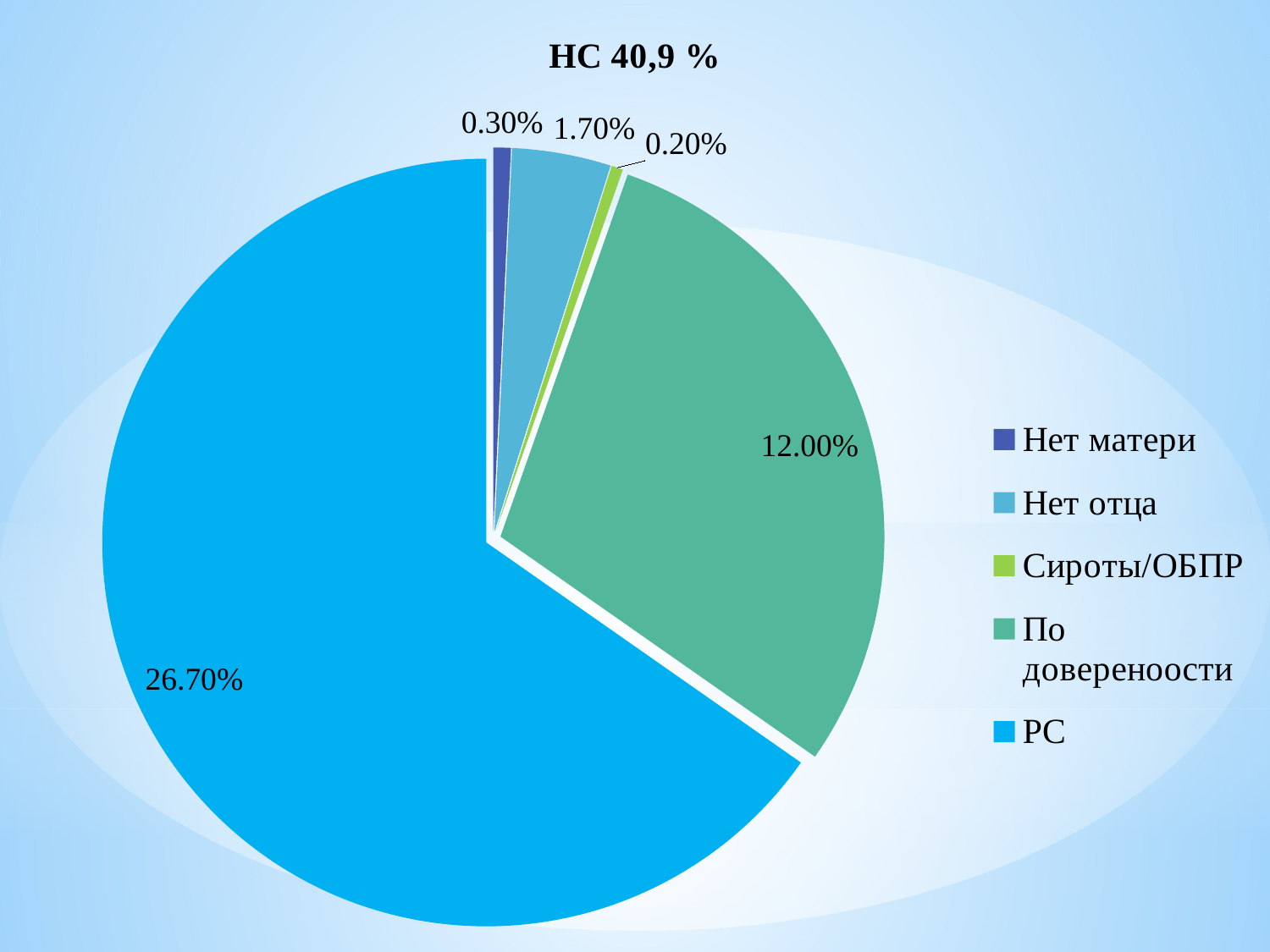
Which is larger, the value for Нет отца or the value for Нет матери? Нет отца Which category has the largest slice of the pie? РС What value is shown for the Нет матери slice? 0.30% What value is shown for the По довереноости slice? 12.00% What type of chart is shown on the slide? pie chart What value is shown for the Сироты/ОБПР slice? 0.20% What is the title of the chart? НС 40,9 % How many categories does the legend list? 5 What is the difference between the values for РС and По довереноости? 14.70% Which category has the smallest slice of the pie? Сироты/ОБПР What value is shown for the Нет отца slice? 1.70% What value is shown for the РС slice? 26.70%